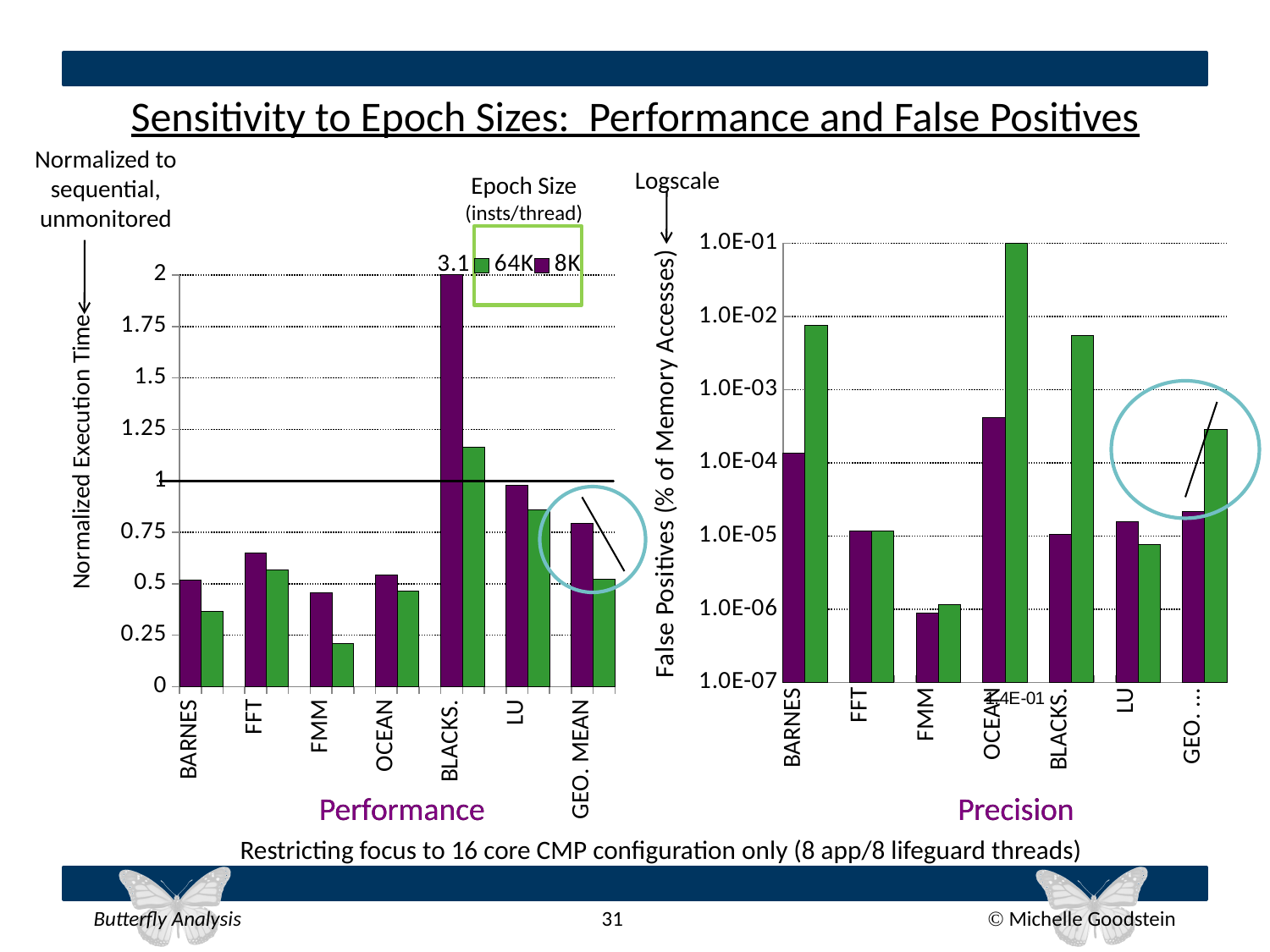
In the Performance chart, is the 64K value for FMM greater or less than 0.25? less In the Performance chart, which is larger for BARNES, the 8K bar or the 64K bar? 8K In the Precision chart, what is the false positive value for OCEAN with the 64K epoch size? 2.4E-01 In the Precision chart, which category has the highest 64K bar? OCEAN In the Performance chart, what is the normalized execution time for BLACKS. with the 8K epoch size? 3.1 What kind of chart is the Performance chart on the left? bar chart In the Performance chart, is the 64K value for BLACKS. greater or less than 1? greater How many series does the legend list for the charts? 2 How many categories are shown on the x axis of the Performance chart? 7 In the Performance chart, which category has the highest 8K bar? BLACKS. In the Performance chart, which category has the lowest 64K bar? FMM